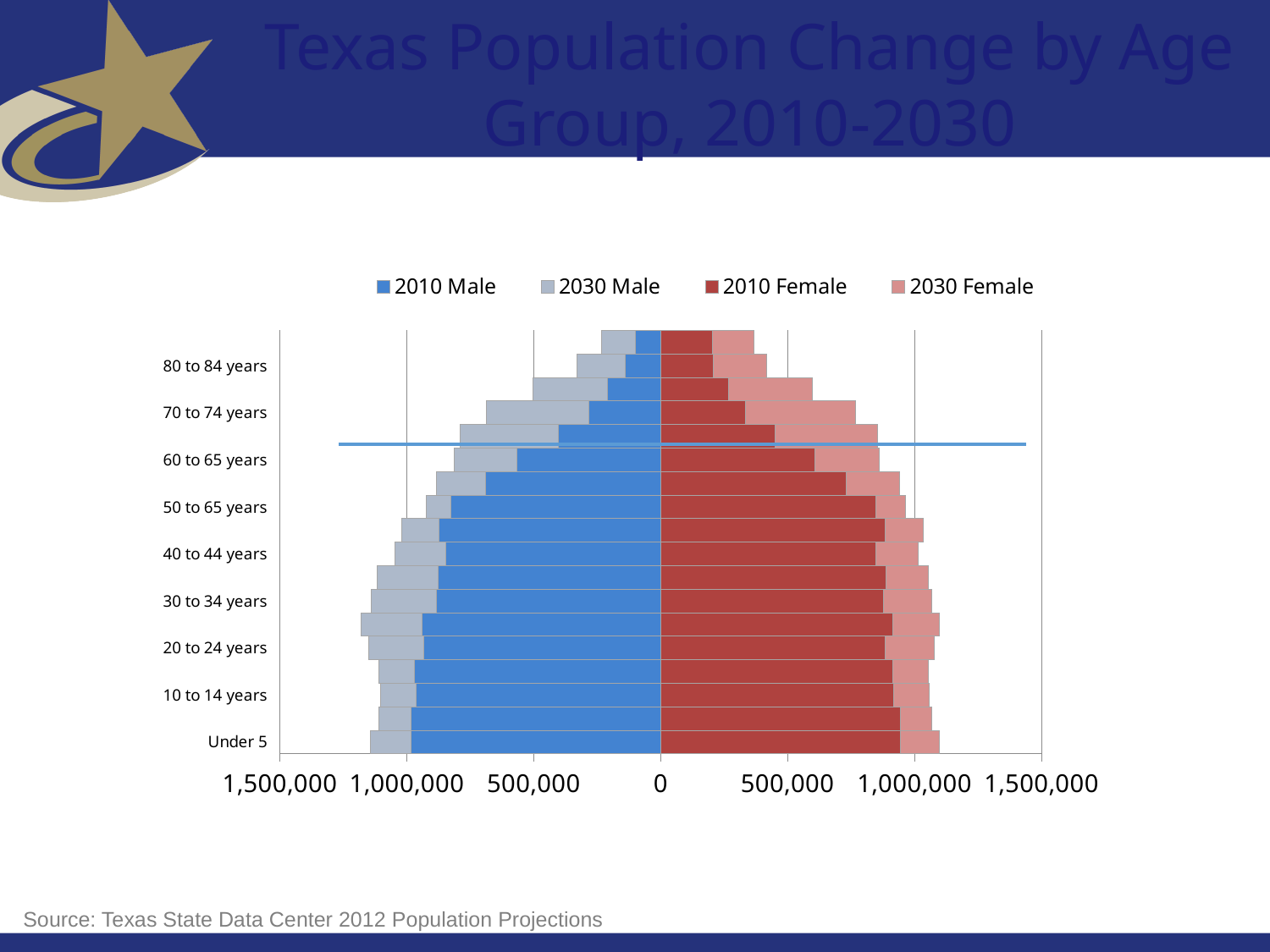
What is the title of the chart? Texas Population Change by Age Group, 2010-2030 Do the 2010 Male values rise or fall as the age group increases from Under 5 to 80 to 84 years? fall Among the labeled age groups, which has the smallest 2010 Male value? 80 to 84 years What kind of chart is shown on the slide? Bar chart (population pyramid) Is the 2010 Male value for 80 to 84 years greater or less than 500,000? less Is the 2010 Female value for 70 to 74 years greater or less than 500,000? less How many series does the legend list? 4 For 70 to 74 years, which is larger: the 2010 Male value or the 2030 Male value? 2030 Male Which series are listed in the legend? 2010 Male, 2030 Male, 2010 Female, 2030 Female